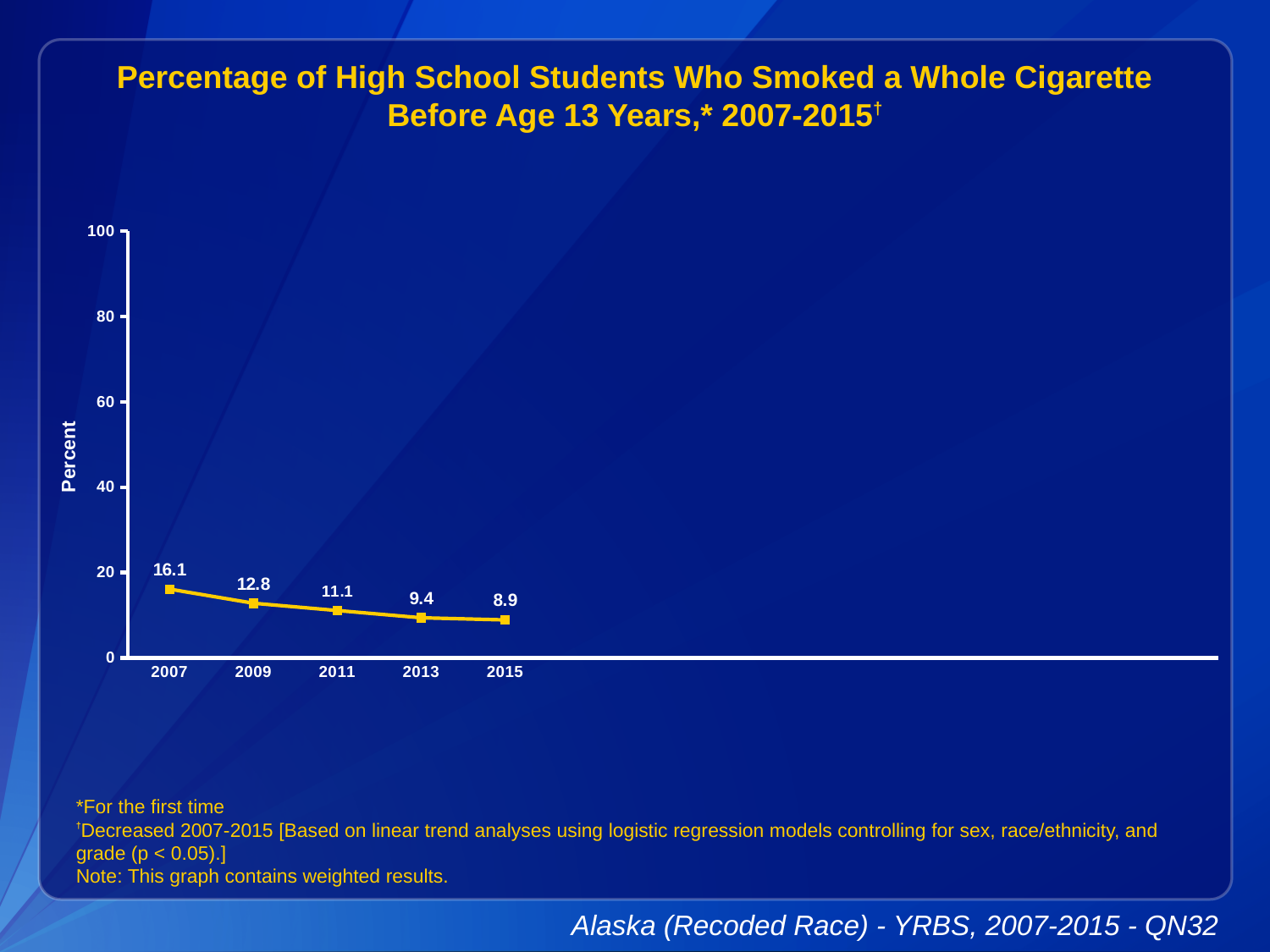
What percentage of high school students smoked a whole cigarette before age 13 in 2007? 16.1 What is the difference between the 2009 value and the 2013 value? 3.4 Is the value for 2007 greater or less than 20? less How many years are plotted on the chart? 5 What kind of chart is shown on the slide? line chart Do the values rise or fall from 2007 to 2015? fall Which year has the highest value on the chart? 2007 Which year has a larger value, 2009 or 2013? 2009 Which year has the lowest value on the chart? 2015 What is the difference between the 2007 value and the 2015 value? 7.2 What is the value plotted for 2011? 11.1 What is the value plotted for 2015? 8.9